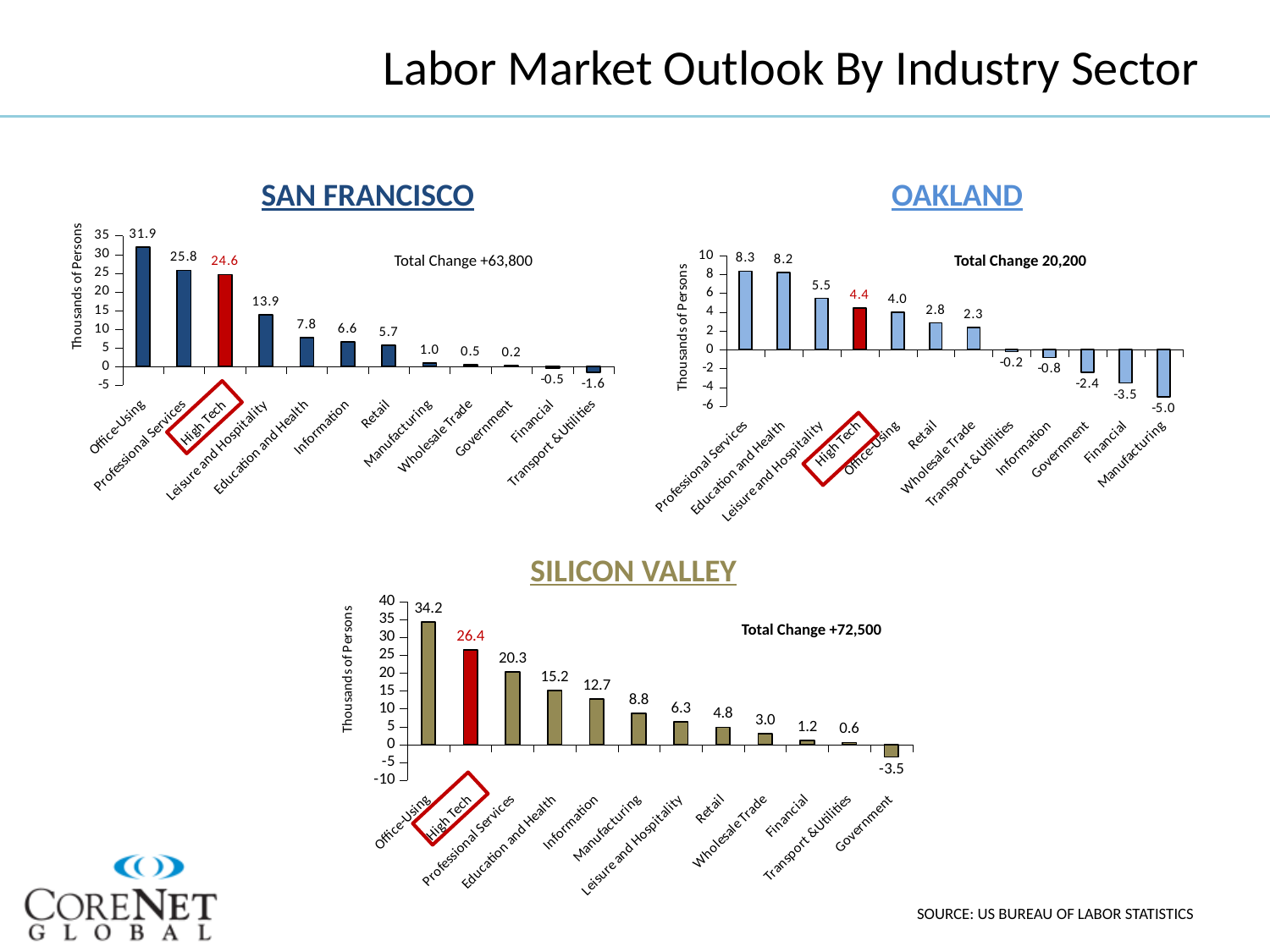
In the Oakland chart, what is the value for Manufacturing? -5.0 In the Oakland chart, is the value for Leisure and Hospitality greater or less than 4? greater In the San Francisco chart, what is the value for High Tech? 24.6 In the San Francisco chart, which is larger, Leisure and Hospitality or Education and Health? Leisure and Hospitality What total change is stated on the San Francisco chart? +63,800 In the Oakland chart, which category has the highest value? Professional Services What kind of chart is the Oakland chart? Bar chart In the Silicon Valley chart, do the values rise or fall from left to right along the x axis? Fall In the Silicon Valley chart, what is the difference between Office-Using and High Tech? 7.8 How many categories are shown in the Silicon Valley chart? 12 In the Silicon Valley chart, what is the value for Information? 12.7 In the San Francisco chart, which category has the lowest value? Transport & Utilities